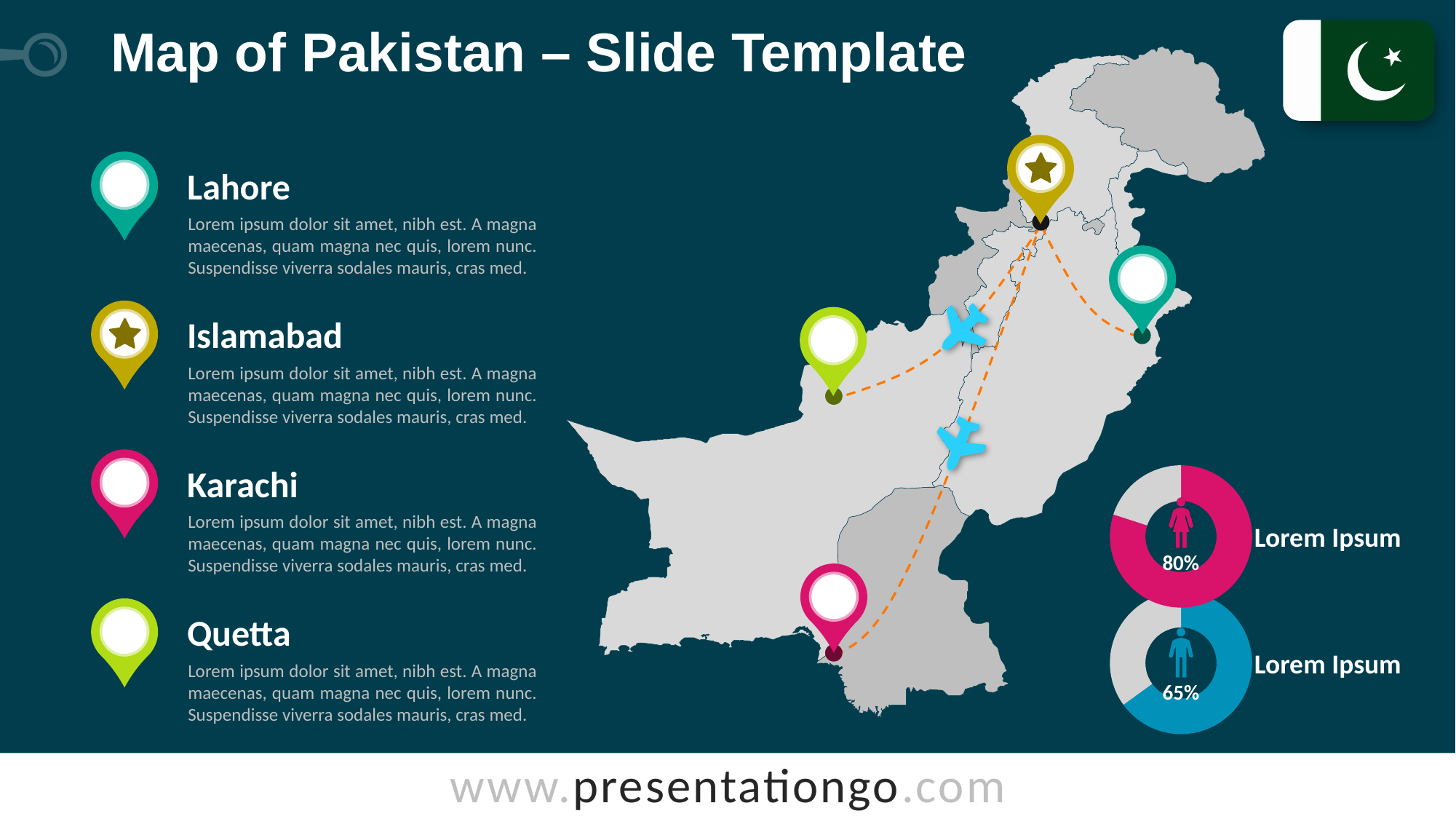
Which of the two donut charts shows the larger value, the upper pink one or the lower blue one? the upper pink one How many donut charts are shown on the slide? 2 What label appears next to the upper pink donut chart? Lorem Ipsum What is the difference between the values shown in the upper pink donut chart and the lower blue donut chart? 15% Is the value in the upper pink donut chart greater or less than 75%? greater What share of the upper pink donut chart is filled? 80% What colour is the filled portion of the lower donut chart showing 65%? blue What kind of chart is used to display the 80% and 65% values on the right of the slide? donut chart What share of the lower blue donut chart is filled? 65% Is the value in the lower blue donut chart greater or less than 70%? less What value is shown in the upper (pink) donut chart on the right of the slide? 80% What value is shown in the lower (blue) donut chart on the right of the slide? 65%